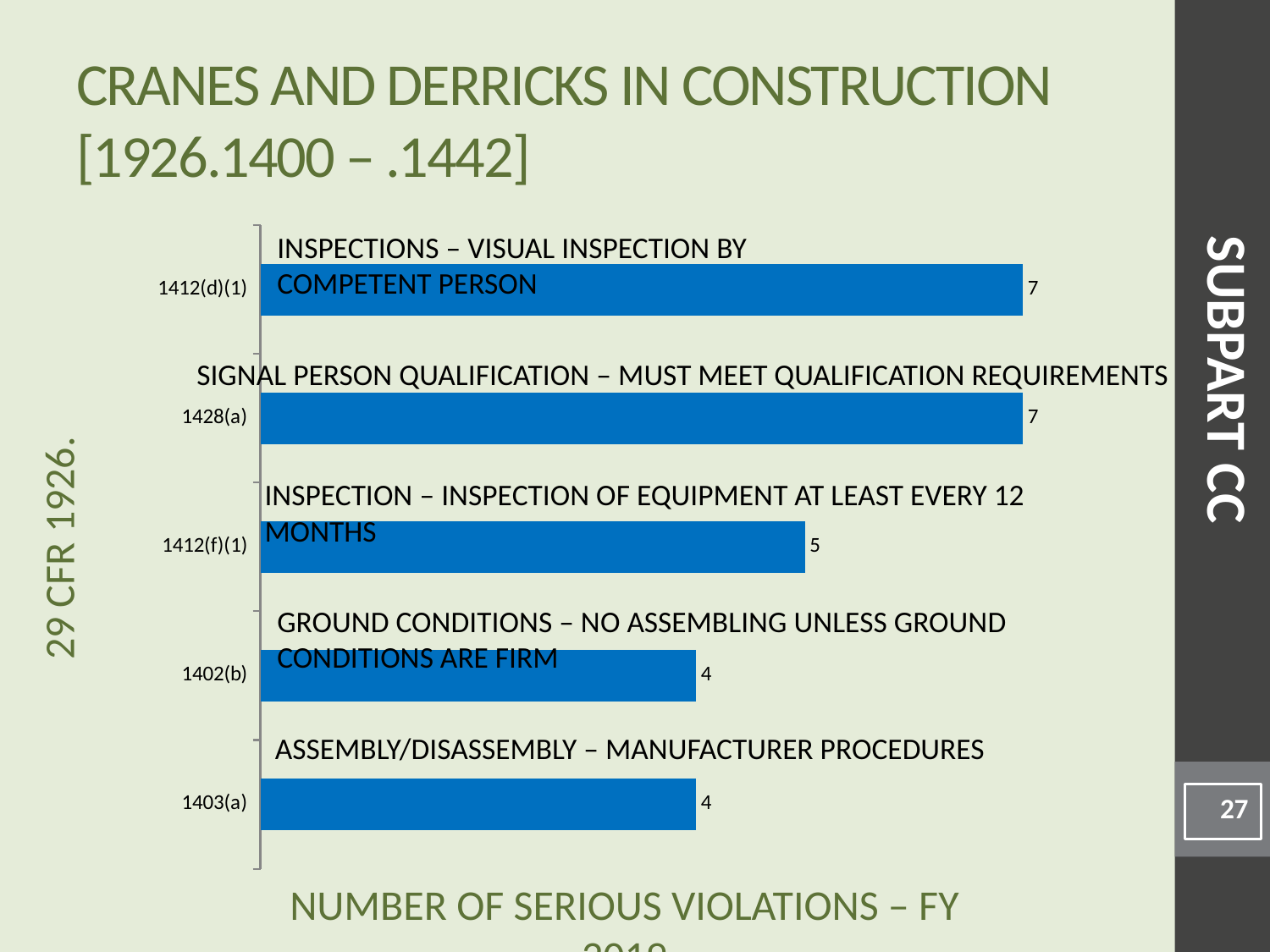
What kind of chart is shown on the slide? Bar chart Which is larger, the value for 1412(f)(1) or the value for 1402(b)? 1412(f)(1) What is the total of all the values shown in the chart? 27 What is the number of serious violations for 1428(a)? 7 What is the number of serious violations for 1412(f)(1)? 5 What is the number of serious violations for 1402(b)? 4 What is the difference between the values for 1428(a) and 1402(b)? 3 What is the number of serious violations for 1403(a)? 4 What is the number of serious violations for 1412(d)(1)? 7 How many categories are shown in the chart? 5 Which category has the lowest value, 1412(f)(1) or 1403(a)? 1403(a)